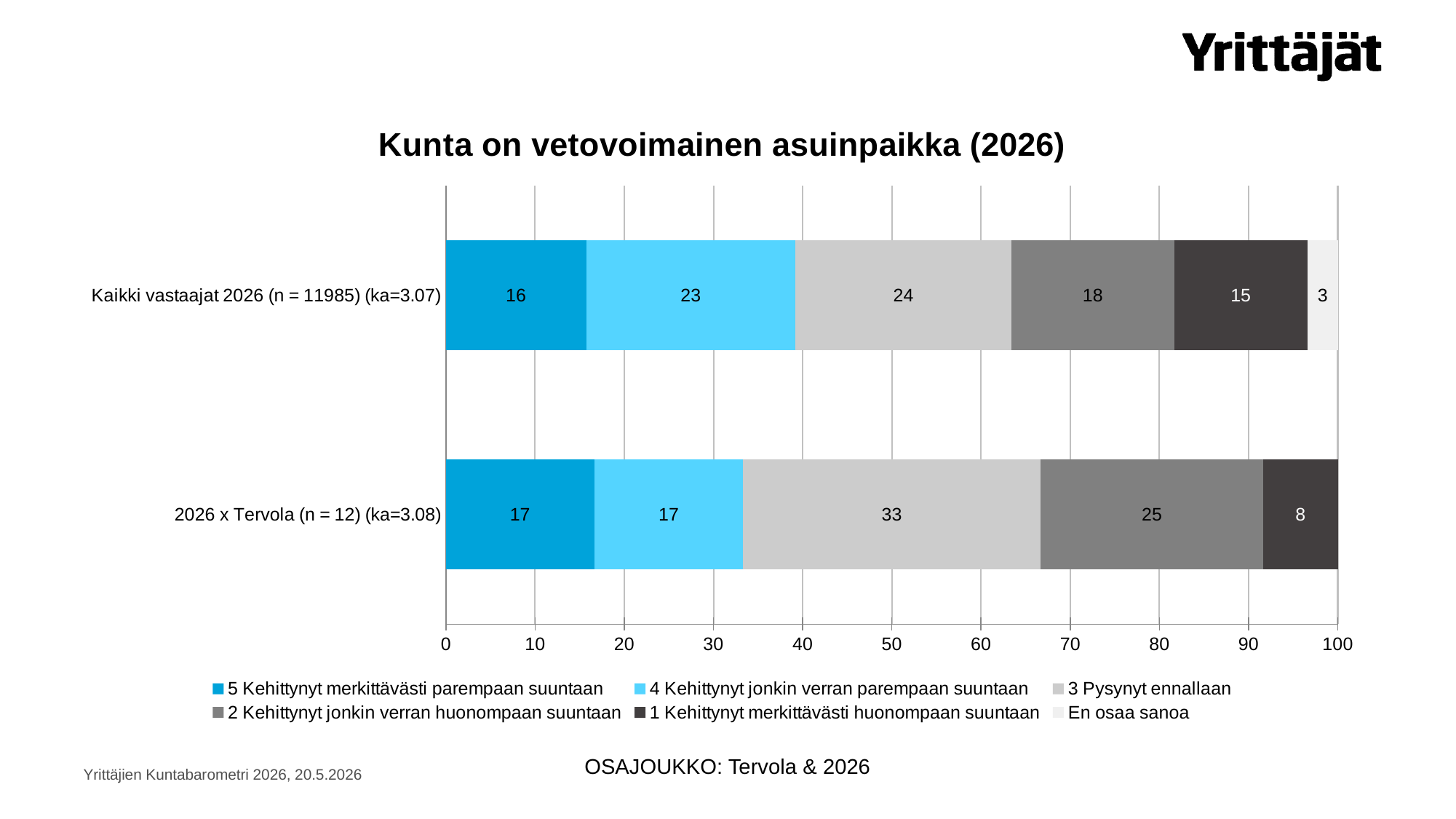
How many categories (bars) does the chart show? 2 What is the difference in "2 Kehittynyt jonkin verran huonompaan suuntaan" between "2026 x Tervola" and "Kaikki vastaajat 2026"? 7 Which series has the smallest segment in the "Kaikki vastaajat 2026 (n = 11985) (ka=3.07)" bar? En osaa sanoa What is the total of the stacked bar for "Kaikki vastaajat 2026 (n = 11985) (ka=3.07)"? 99 What is the value of "1 Kehittynyt merkittävästi huonompaan suuntaan" for "2026 x Tervola (n = 12) (ka=3.08)"? 8 What is the value of "5 Kehittynyt merkittävästi parempaan suuntaan" for "Kaikki vastaajat 2026 (n = 11985) (ka=3.07)"? 16 Which series has the largest segment in the "2026 x Tervola (n = 12) (ka=3.08)" bar? 3 Pysynyt ennallaan What is the title of the chart? Kunta on vetovoimainen asuinpaikka (2026) What kind of chart is shown on the slide? Stacked bar chart How many series does the legend list? 6 Which category has the larger value for "4 Kehittynyt jonkin verran parempaan suuntaan": "Kaikki vastaajat 2026" or "2026 x Tervola"? Kaikki vastaajat 2026 What is the value of "3 Pysynyt ennallaan" for "2026 x Tervola (n = 12) (ka=3.08)"? 33